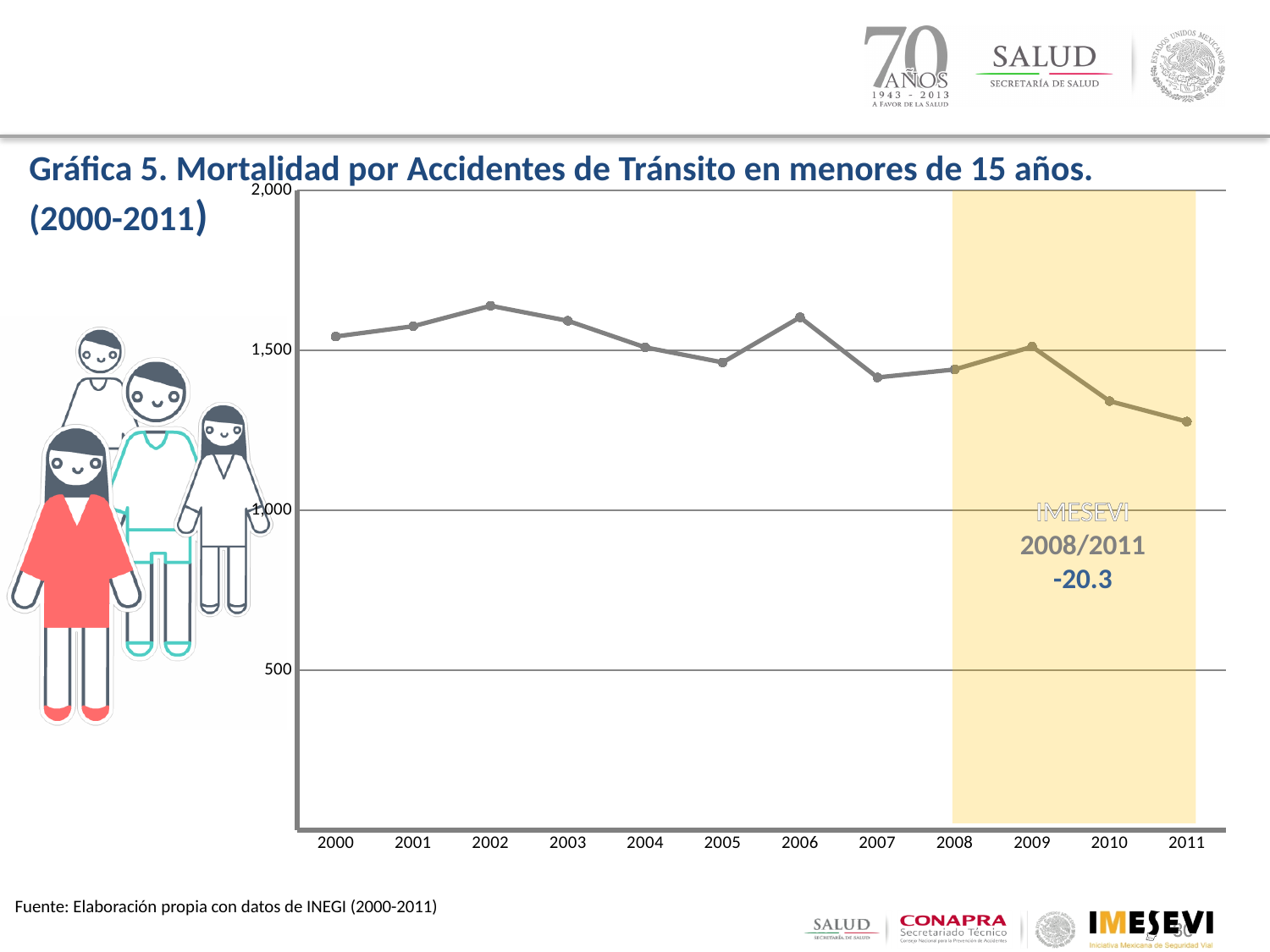
Is the value for 2002 greater or less than 1,500? greater Is the value for 2007 greater or less than 1,500? less Which year has the larger value, 2000 or 2011? 2000 What percentage change is printed in the shaded 2008/2011 region of the chart? -20.3 Is the value for 2011 greater or less than 1,500? less Which year has the highest value on the chart? 2002 What kind of chart is shown on the slide? line chart Which year has the larger value, 2006 or 2007? 2006 Which year has the lowest value on the chart? 2011 How many years (data points) are plotted on the x axis? 12 Do the values rise or fall from 2009 to 2011? fall